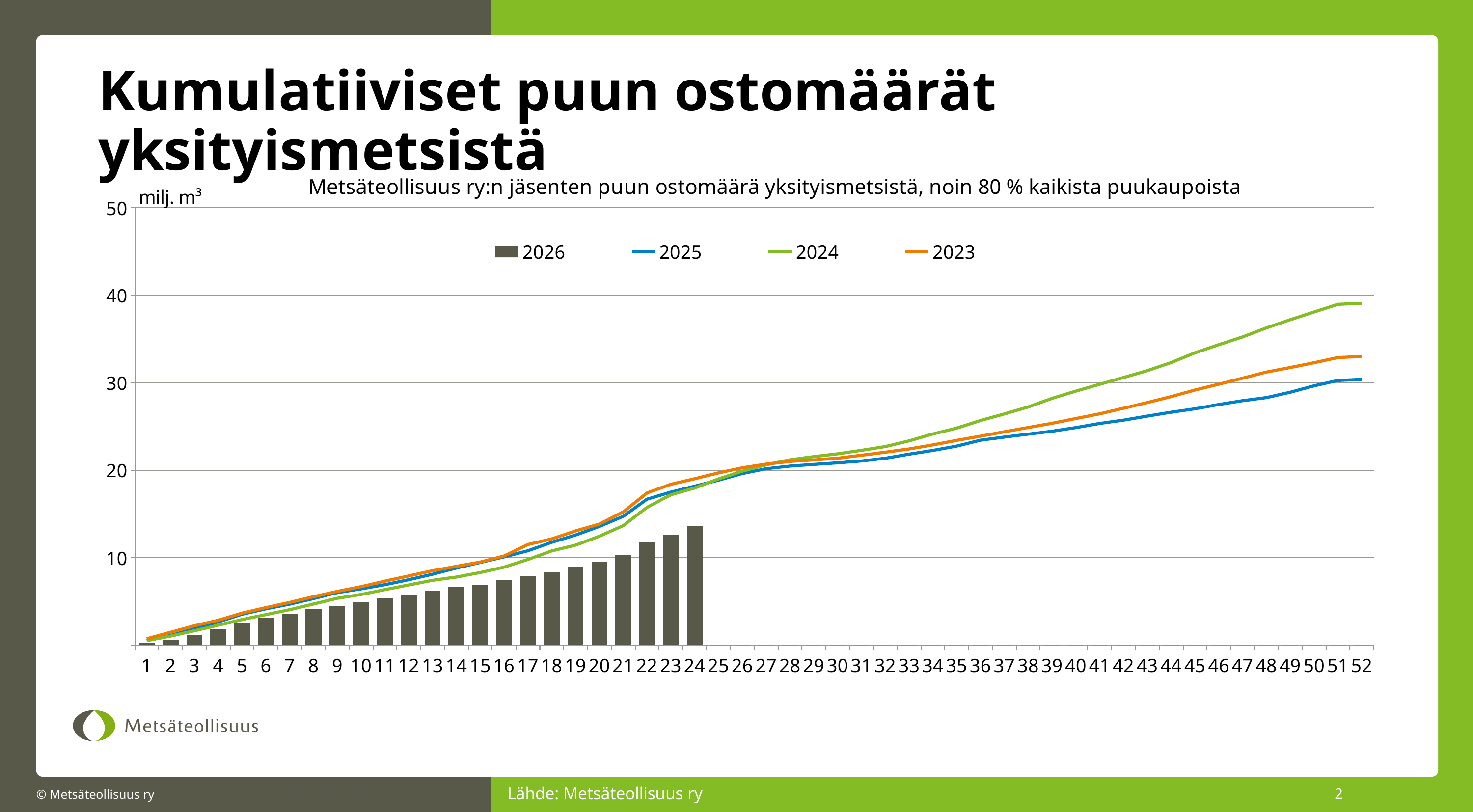
What unit is shown on the y axis of the chart? milj. m³ At week 24, which is larger: the 2026 bar or the 2025 line? 2025 Do the 2026 bars rise or fall from week 1 to week 24? rise Is the value for the 2026 bar at week 24 greater or less than 10? greater Which years are listed in the chart legend? 2026, 2025, 2024, 2023 Is the value for 2024 at week 52 greater or less than 35? greater How many bars are plotted for the 2026 series? 24 Which series has the highest value at week 52? 2024 How many week categories are shown on the x axis? 52 What kind of chart is shown on the slide? Combined bar and line chart How many series does the chart legend list? 4 Which series has the lowest value at week 52? 2025